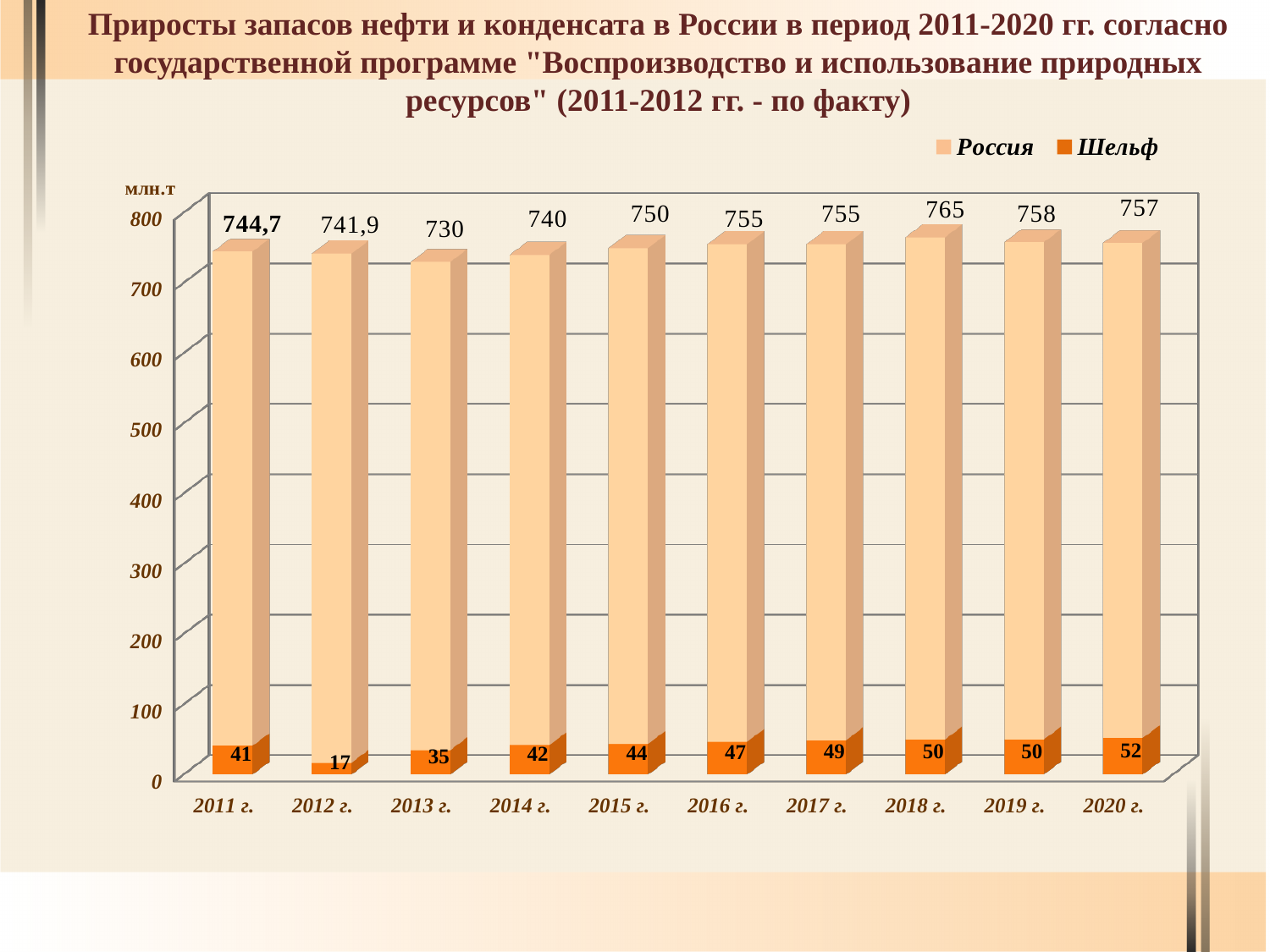
What is the difference between the Шельф values in 2020 г. and 2011 г.? 11 How many series does the legend list? 2 In which year is the Шельф value the lowest? 2012 г. Which is larger, the Россия value in 2015 г. or in 2016 г.? 2016 г. How many years are shown on the x axis? 10 What is the difference between the Россия and Шельф values in 2013 г.? 695 In which year is the Россия value the highest? 2018 г. What kind of chart is shown on the slide? Bar chart What is the value for Шельф in 2012 г.? 17 In which year is the Шельф value the highest? 2020 г. What is the value for Россия in 2018 г.? 765 What is the value for Россия in 2011 г.? 744,7